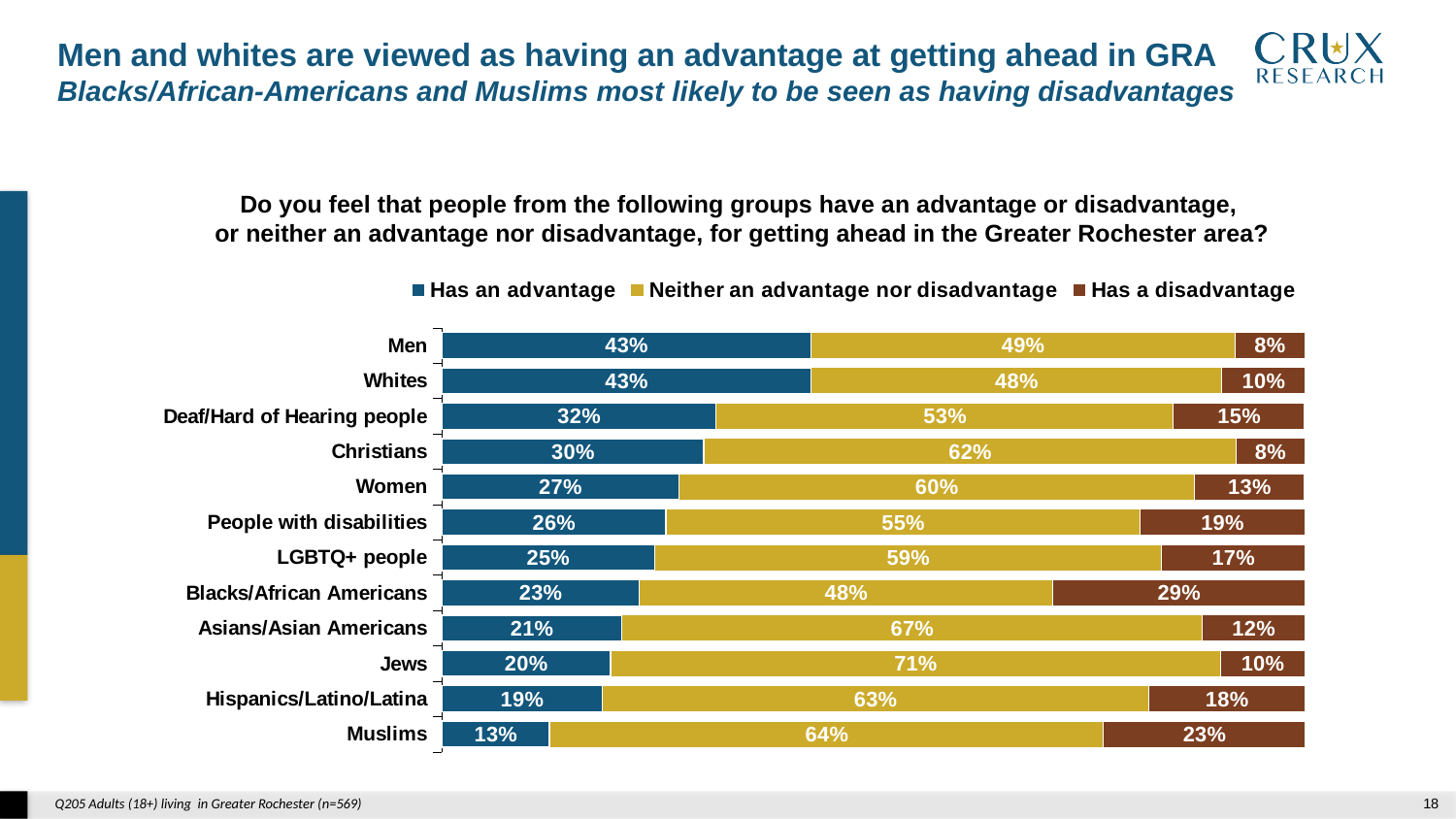
What is the difference between the 'Has a disadvantage' percentages for Blacks/African Americans and Hispanics/Latino/Latina? 11% Which is larger: the 'Has an advantage' percentage for Women or for People with disabilities? Women What is the total of the three segments in the bar for Christians? 100% Which group has the highest percentage for 'Has a disadvantage'? Blacks/African Americans Which group has the lowest percentage for 'Has an advantage'? Muslims How many series does the legend list? 3 What type of chart is shown on the slide? Stacked bar chart Which group has the highest percentage for 'Neither an advantage nor disadvantage'? Jews What percentage say Jews have neither an advantage nor disadvantage? 71% What percentage of respondents say Men have an advantage at getting ahead in the Greater Rochester area? 43% What percentage say Muslims have a disadvantage? 23% How many groups are shown in the chart? 12